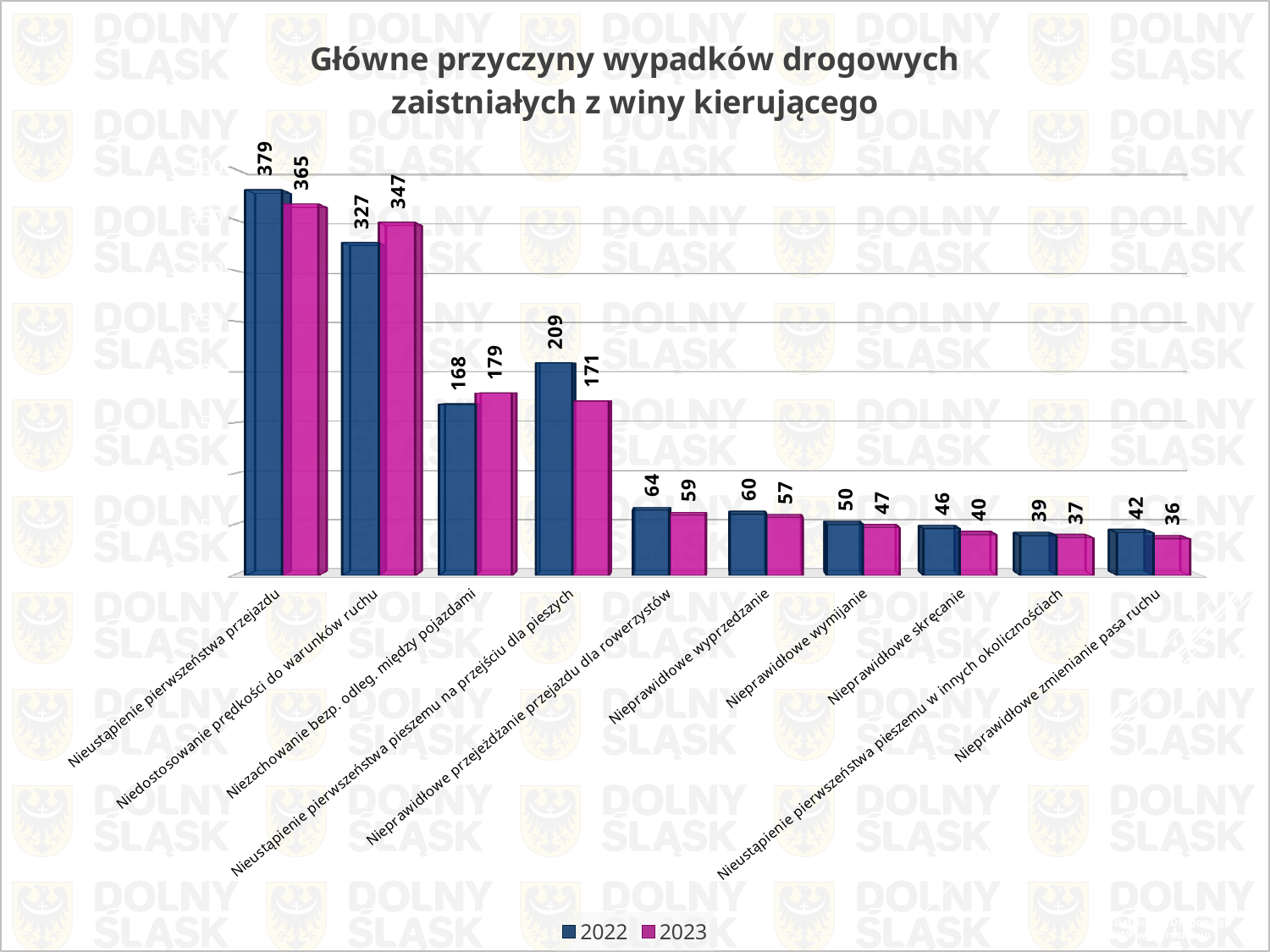
What is the 2023 value for Niedostosowanie prędkości do warunków ruchu? 347 What is the 2023 value for Nieprawidłowe wyprzedzanie? 57 Which category has the highest 2022 value? Nieustąpienie pierwszeństwa przejazdu What is the difference between the 2023 values for Niedostosowanie prędkości do warunków ruchu and Niezachowanie bezp. odleg. między pojazdami? 168 What is the title of the chart? Główne przyczyny wypadków drogowych zaistniałych z winy kierującego For Niezachowanie bezp. odleg. między pojazdami, which year has the larger value, 2022 or 2023? 2023 How many series does the legend list? 2 How many categories are shown on the x axis? 10 What is the difference between the 2022 and 2023 values for Nieustąpienie pierwszeństwa pieszemu na przejściu dla pieszych? 38 Which category has the lowest 2023 value? Nieprawidłowe zmienianie pasa ruchu What kind of chart is shown on the slide? Bar chart What is the 2022 value for Nieustąpienie pierwszeństwa przejazdu? 379